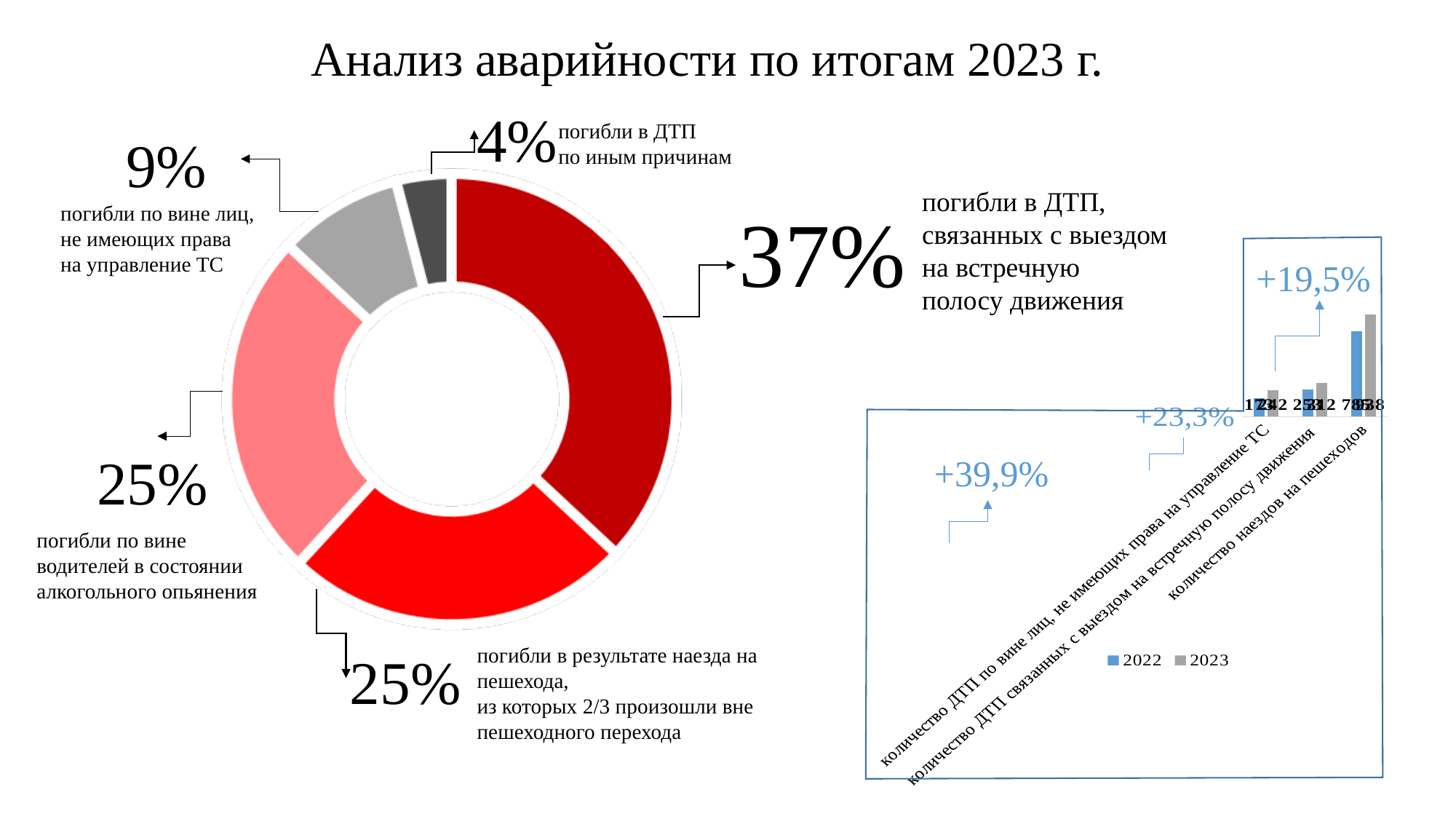
On the donut chart on the left, how many segments does the chart have? 5 On the donut chart on the left, what is the difference in percentage points between the share for driving into the oncoming lane and the share for drivers without a licence? 28 On the donut chart on the left, what share of deaths is attributed to persons without a driving licence (лица, не имеющие права на управление ТС)? 9% On the donut chart on the left, what share of deaths is attributed to other causes (иные причины)? 4% On the donut chart on the left, which category has the largest share? погибли в ДТП, связанных с выездом на встречную полосу движения What kind of chart is the chart on the left of the slide? donut (pie) chart On the donut chart on the left, which category has the smallest share? погибли в ДТП по иным причинам On the bar chart on the right, how many series does the legend list? 2 On the bar chart on the right, which category has the tallest bars? количество наездов на пешеходов On the donut chart on the left, what share of deaths is attributed to accidents involving driving into the oncoming lane (выезд на встречную полосу движения)? 37% On the bar chart on the right, how many categories are shown on the x axis? 3 On the donut chart on the left, which is larger: the share for drunk drivers (водители в состоянии алкогольного опьянения) or the share for drivers without a licence? водители в состоянии алкогольного опьянения